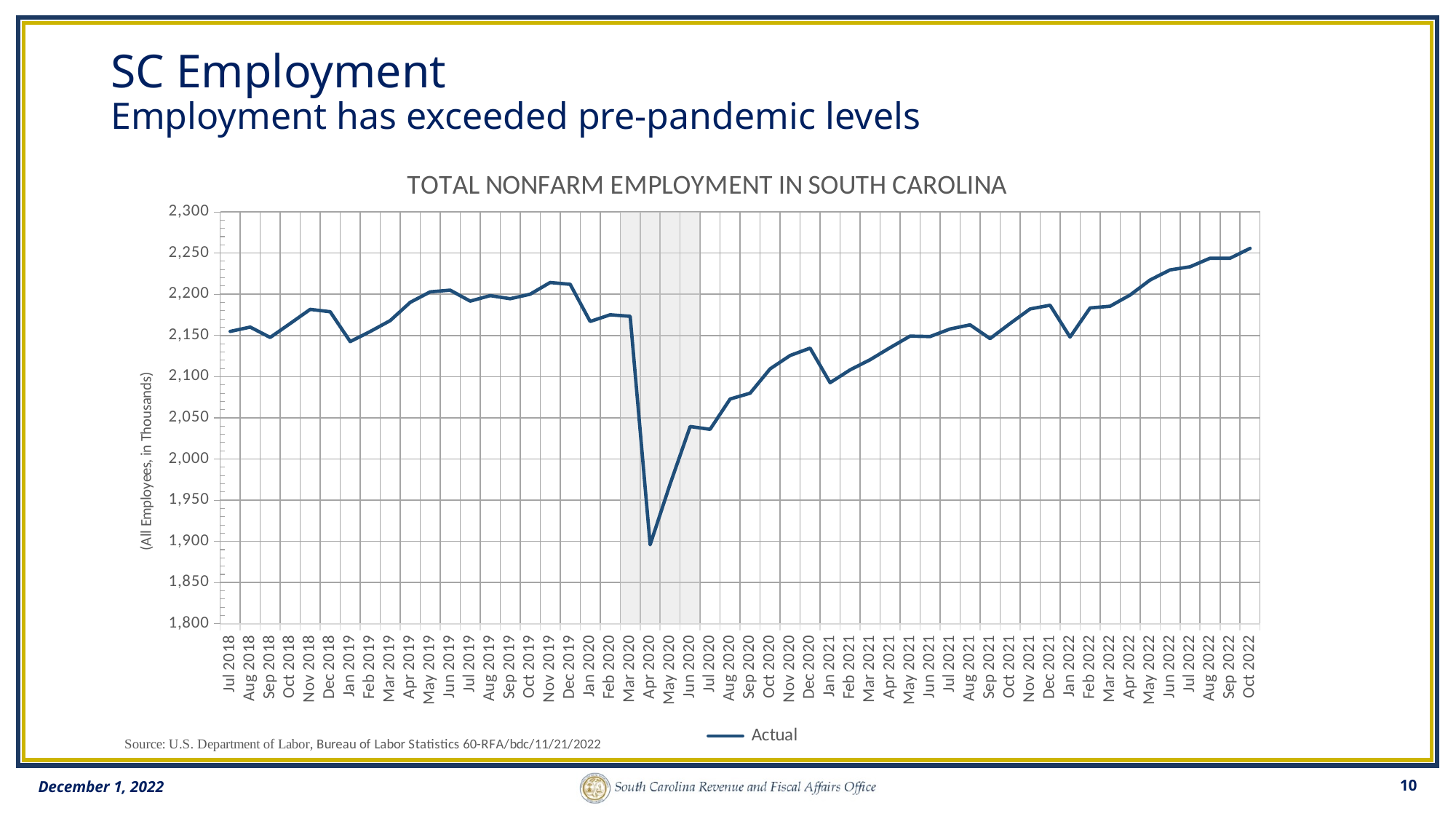
What is the name of the series shown in the legend? Actual How many monthly data points are plotted on the chart? 52 What kind of chart is shown on the slide? line chart What is the title of the chart? TOTAL NONFARM EMPLOYMENT IN SOUTH CAROLINA Does employment rise or fall from Apr 2020 to Oct 2022? rise Which is larger, the value for Dec 2019 or the value for Jan 2020? Dec 2019 In which month is total nonfarm employment highest? Oct 2022 Is the value for Apr 2020 greater or less than 1,950? less How many series does the legend list? 1 Is the value for Jan 2021 greater or less than 2,050? greater Is the value for Oct 2022 greater or less than 2,200? greater In which month is total nonfarm employment lowest? Apr 2020